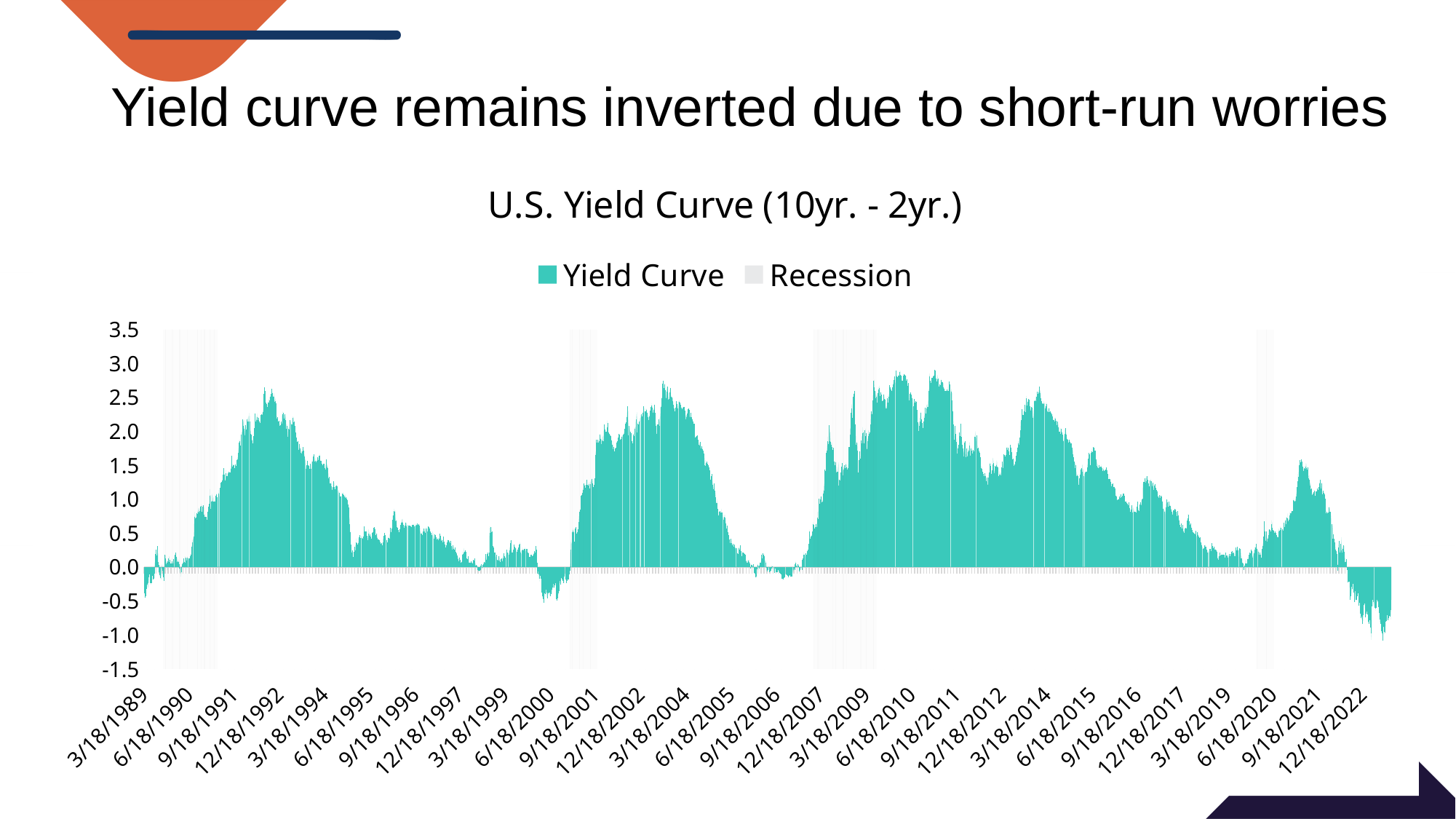
Around which x-axis date does the Yield Curve reach its lowest value? 12/18/2022 What are the two entries in the chart legend? Yield Curve and Recession Does the Yield Curve rise or fall between 6/18/2020 and 9/18/2021? rise How many series does the legend list? 2 Is the Yield Curve value at 12/18/2022 greater or less than 0.0? less Is the Yield Curve value at 6/18/2010 greater or less than 2.0? greater Does the Yield Curve rise or fall between 9/18/2021 and 12/18/2022? fall Which is larger, the Yield Curve value at 6/18/2010 or at 3/18/1994? 6/18/2010 Is the Yield Curve value at 3/18/1994 greater or less than 1.0? greater What is the title of the chart? U.S. Yield Curve (10yr. - 2yr.) What is the highest value shown on the y axis? 3.5